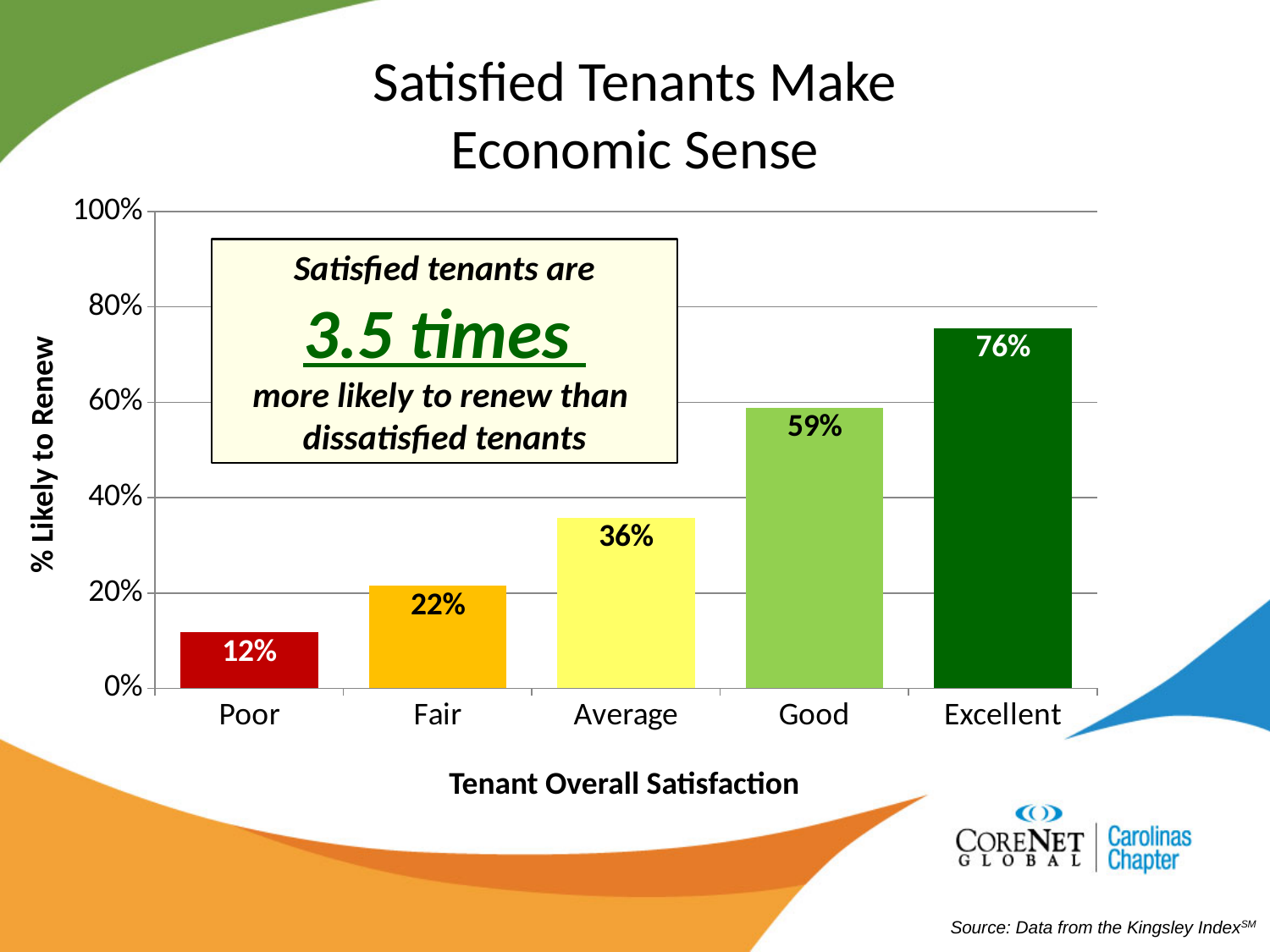
Do the values rise or fall as satisfaction moves from Poor to Excellent along the x axis? Rise What is the % likely to renew for tenants with Poor overall satisfaction? 12% What is the difference in % likely to renew between Good and Fair tenants? 37% What is the label of the y axis? % Likely to Renew Which satisfaction category has the lowest % likely to renew? Poor What is the % likely to renew for tenants with Average overall satisfaction? 36% What is the % likely to renew for tenants with Good overall satisfaction? 59% What kind of chart is shown on the slide? Bar chart How many satisfaction categories are shown on the x axis? 5 What is the difference in % likely to renew between Excellent and Poor tenants? 64% Which satisfaction category has the highest % likely to renew? Excellent Which has a higher % likely to renew, Fair or Average? Average